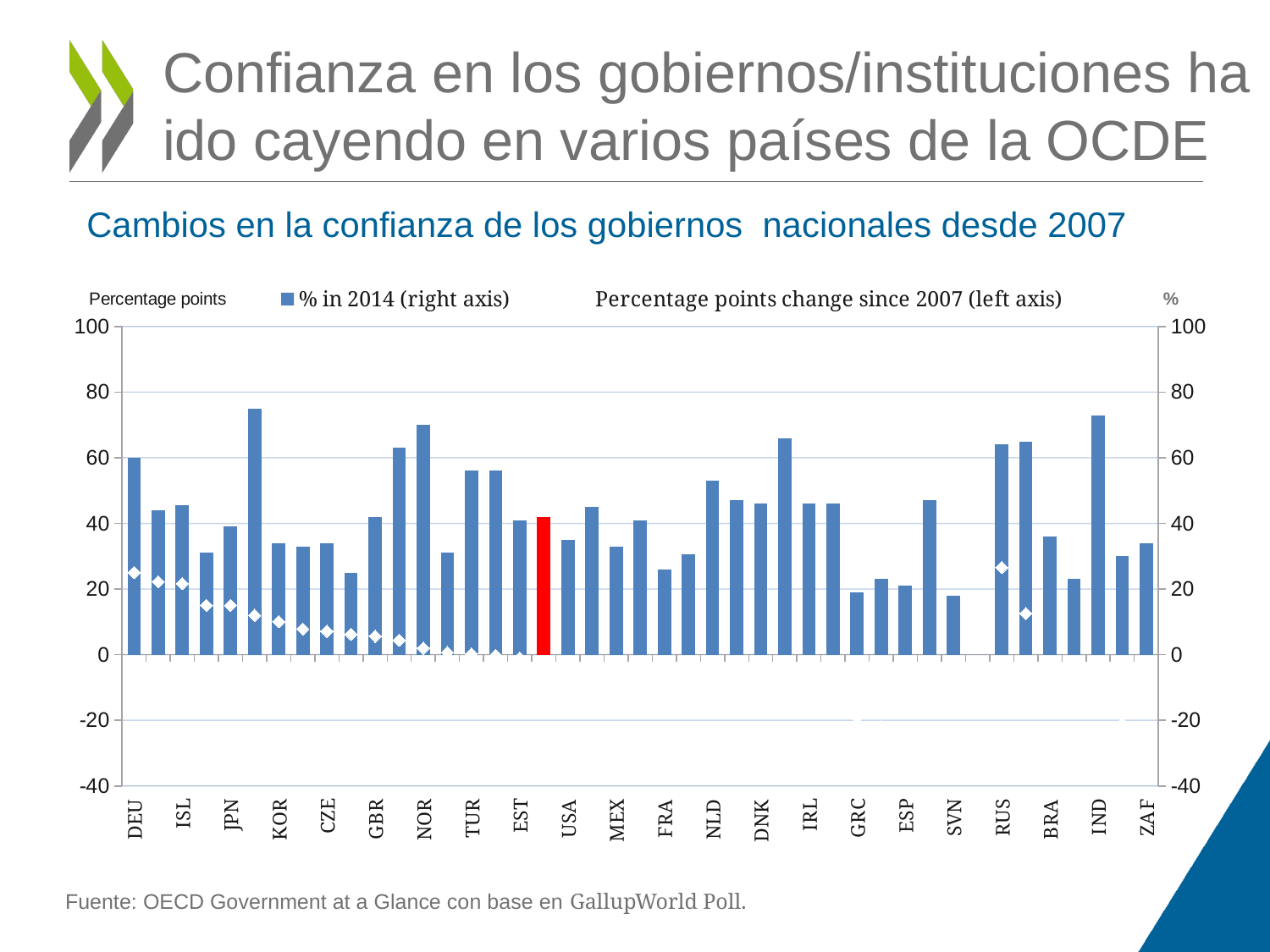
Is the bar value for IND greater or less than 60? greater What are the two entries in the chart legend? % in 2014 (right axis); Percentage points change since 2007 (left axis) Is the bar value for NOR greater or less than 60? greater Which has the taller bar, DEU or GRC? DEU Is the bar value for FRA greater or less than 40? less How many country labels are shown on the x axis of the chart? 22 What is the title of the chart? Cambios en la confianza de los gobiernos nacionales desde 2007 What kind of chart is shown on the slide? combination bar and line chart Which has the taller bar, NOR or USA? NOR How many series does the chart legend list? 2